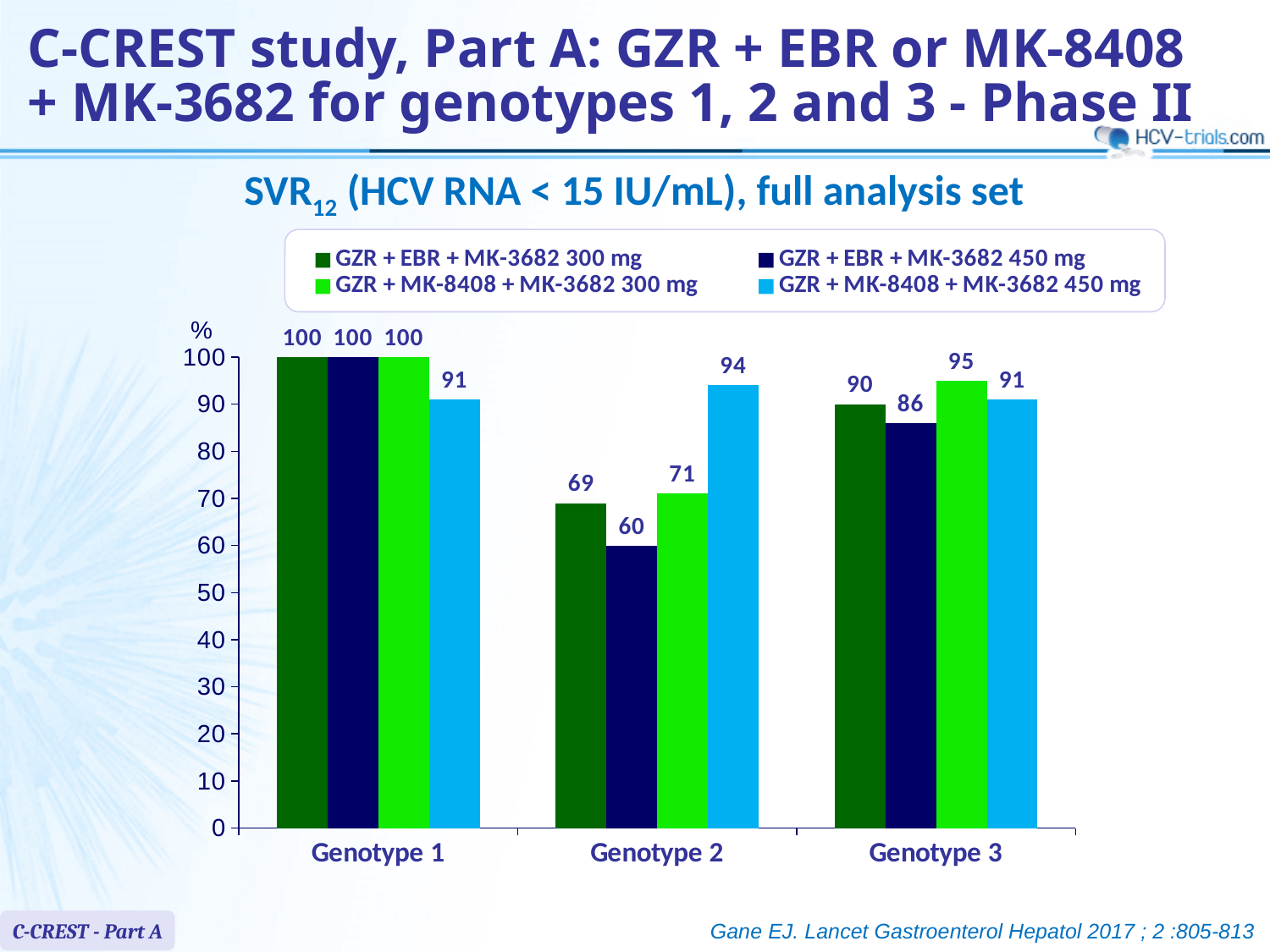
What kind of chart is shown on the slide? Bar chart How many genotype categories are shown on the x axis? 3 How many series does the legend list? 4 What is the SVR12 value for GZR + MK-8408 + MK-3682 300 mg in Genotype 3? 95 What is the SVR12 value for GZR + MK-8408 + MK-3682 450 mg in Genotype 1? 91 In Genotype 3, which is larger: the SVR12 value for GZR + EBR + MK-3682 300 mg or for GZR + MK-8408 + MK-3682 300 mg? GZR + MK-8408 + MK-3682 300 mg Which regimen has the highest SVR12 value in Genotype 2? GZR + MK-8408 + MK-3682 450 mg What is the title of the chart? SVR12 (HCV RNA < 15 IU/mL), full analysis set What is the difference between the SVR12 values for GZR + MK-8408 + MK-3682 450 mg and GZR + EBR + MK-3682 450 mg in Genotype 2? 34 Which regimen has the lowest SVR12 value in Genotype 3? GZR + EBR + MK-3682 450 mg What is the difference between the SVR12 values for GZR + EBR + MK-3682 300 mg in Genotype 1 and Genotype 2? 31 What is the SVR12 value for GZR + EBR + MK-3682 450 mg in Genotype 2? 60